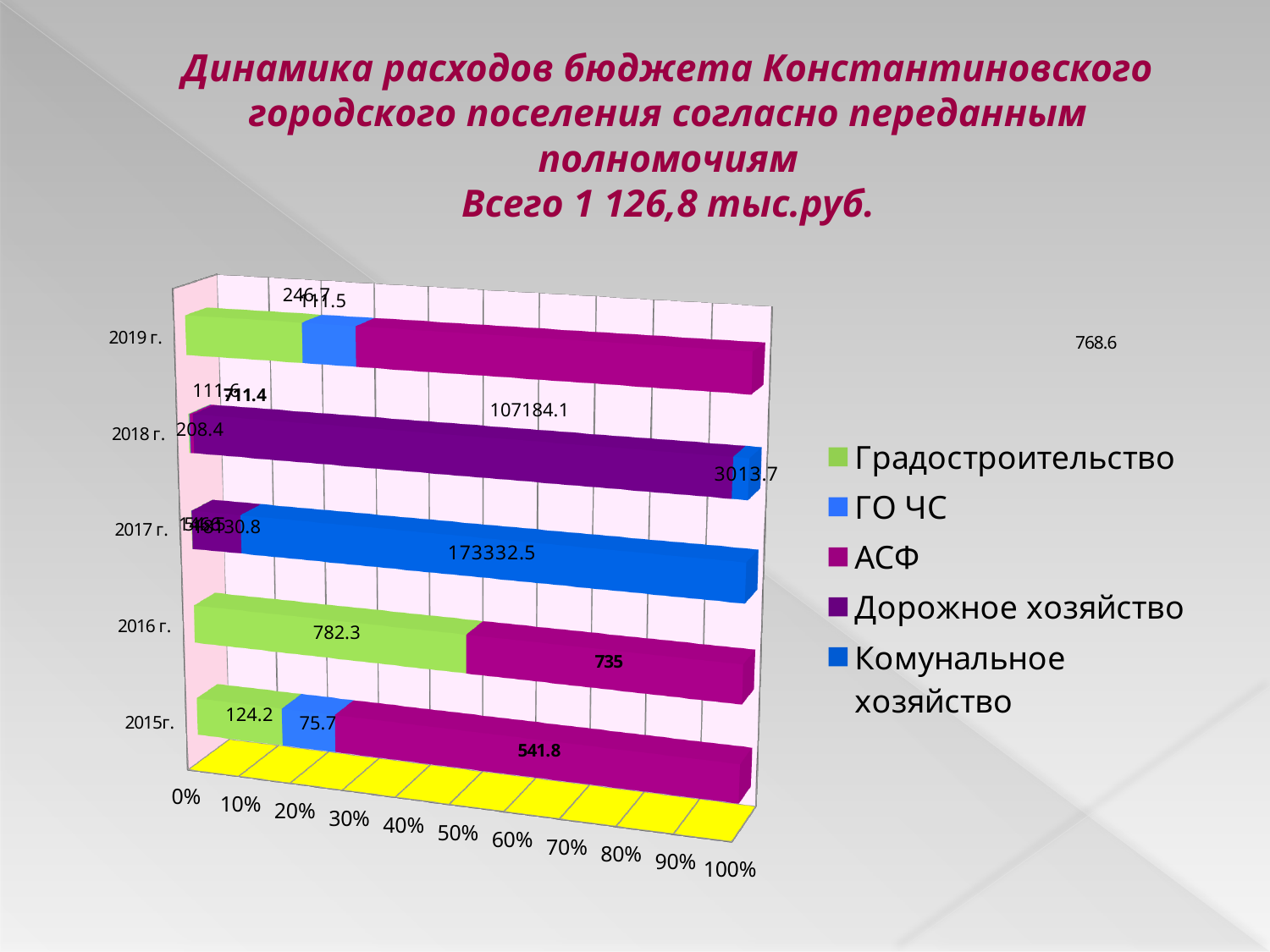
What is the difference between Градостроительство (782.3) and АСФ (735) in 2016 г.? 47.3 What is the value for Градостроительство in 2016 г.? 782.3 What is the value for Градостроительство in 2015г.? 124.2 How many series does the chart legend list? 5 What is the value for Комунальное хозяйство in 2017 г.? 173332.5 What is the value for АСФ in 2015г.? 541.8 How many years (categories) are shown on the vertical axis of the chart? 5 What kind of chart is shown on the slide? bar chart Is the share of the 2015г. bar taken by АСФ greater or less than 60%? greater What is the value for Дорожное хозяйство in 2018 г.? 107184.1 Which is larger in 2015г., Градостроительство or ГО ЧС? Градостроительство What is the value for ГО ЧС in 2015г.? 75.7